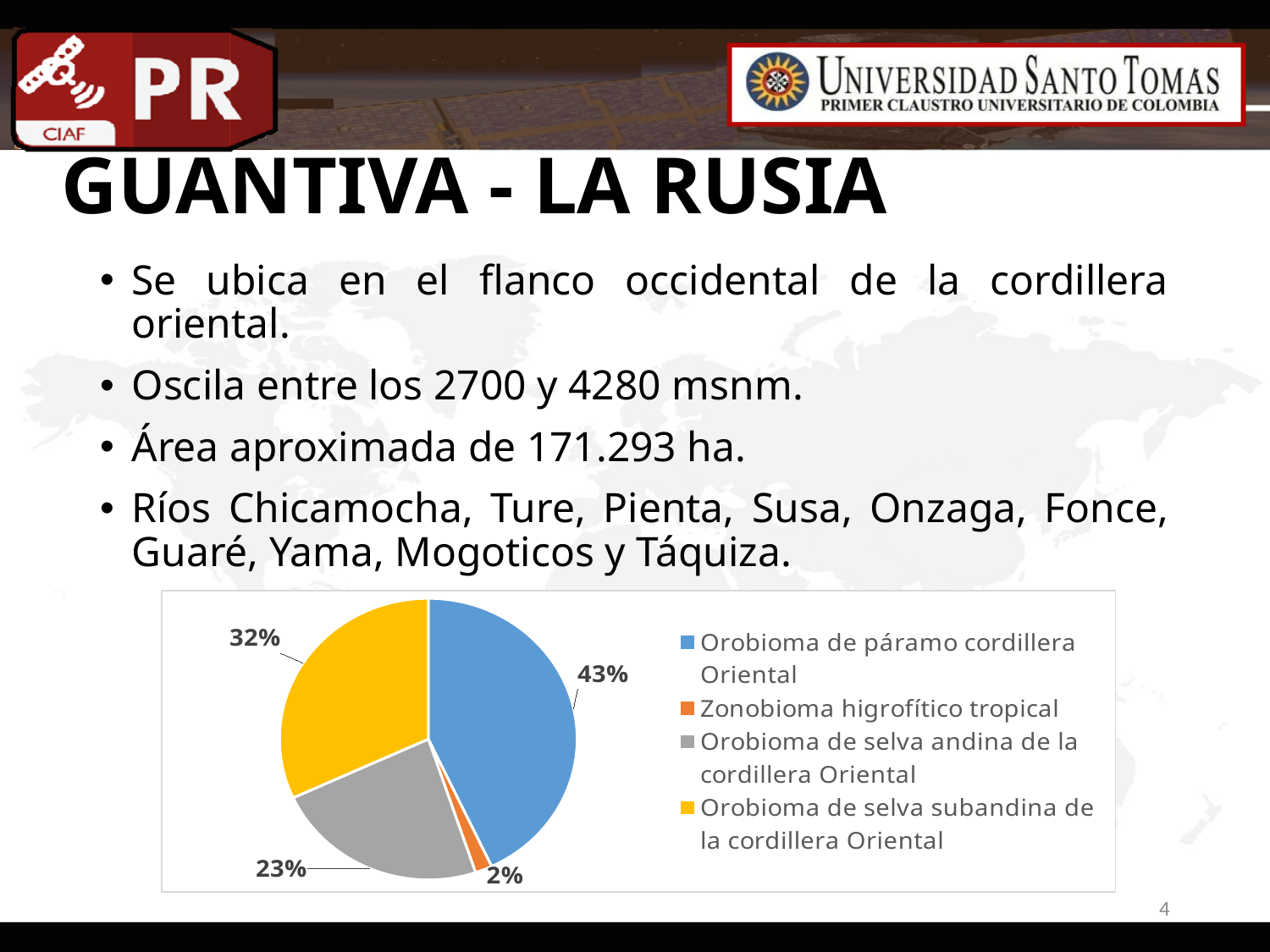
What kind of chart is shown on the slide? pie chart What percentage does the pie chart show for Orobioma de selva andina de la cordillera Oriental? 23% Which category has the smallest slice of the pie chart? Zonobioma higrofítico tropical What percentage does the pie chart show for Orobioma de páramo cordillera Oriental? 43% Which category has the largest slice of the pie chart? Orobioma de páramo cordillera Oriental How many categories does the pie chart show? 4 What colour is the slice for Zonobioma higrofítico tropical? orange What colour is the slice for Orobioma de selva subandina de la cordillera Oriental? yellow What percentage does the pie chart show for Orobioma de selva subandina de la cordillera Oriental? 32% Which is larger in the pie chart: Orobioma de selva andina de la cordillera Oriental or Orobioma de selva subandina de la cordillera Oriental? Orobioma de selva subandina de la cordillera Oriental What is the difference in percentage points between Orobioma de páramo cordillera Oriental and Orobioma de selva subandina de la cordillera Oriental? 11 What percentage does the pie chart show for Zonobioma higrofítico tropical? 2%